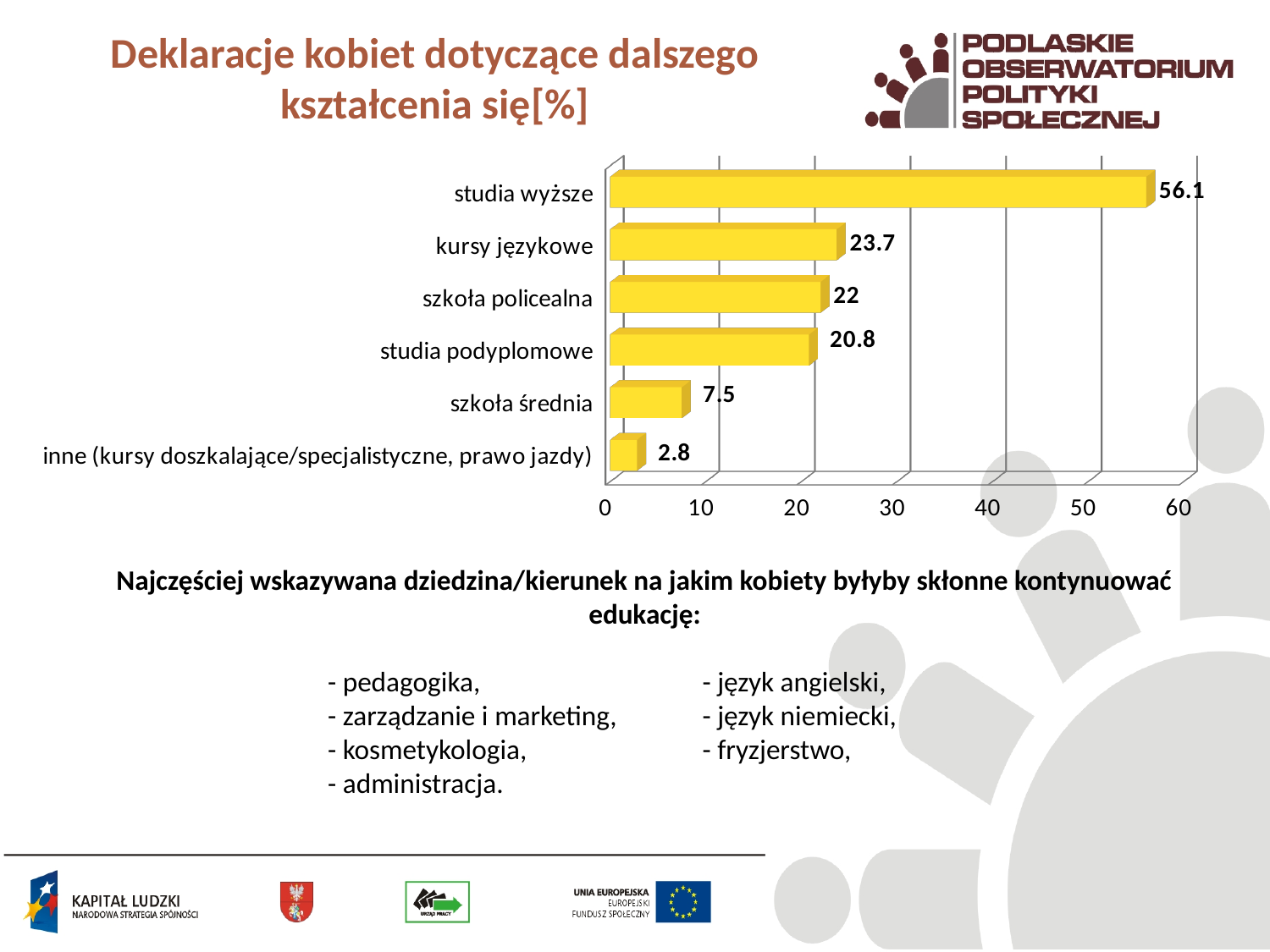
What is the value for studia wyższe? 56.1 What is the difference between the values for szkoła policealna and studia podyplomowe? 1.2 What is the value for kursy językowe? 23.7 What is the difference between the values for studia wyższe and kursy językowe? 32.4 Is the value for studia podyplomowe greater or less than 30? less What is the value for inne (kursy doszkalające/specjalistyczne, prawo jazdy)? 2.8 What kind of chart is shown on the slide? bar chart How many categories are shown in the chart? 6 What is the value for szkoła średnia? 7.5 Which is larger, the value for szkoła policealna or the value for szkoła średnia? szkoła policealna Which category has the lowest value? inne (kursy doszkalające/specjalistyczne, prawo jazdy) Which category has the highest value? studia wyższe